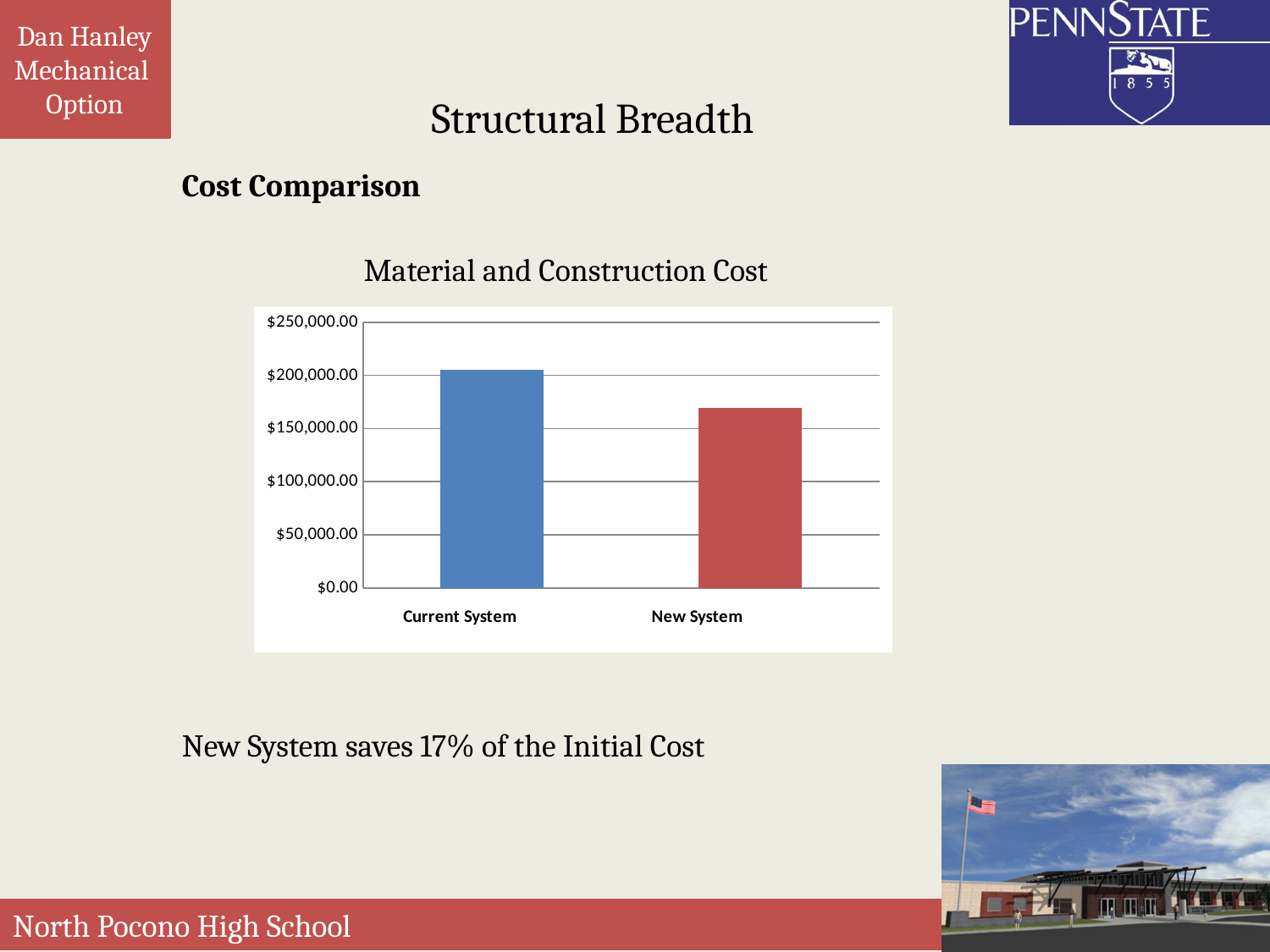
Is the value for New System greater or less than $200,000.00? less Which category has the lowest material and construction cost? New System Which category has the highest material and construction cost? Current System How many categories are shown on the x axis of the chart? 2 What kind of chart is shown on the slide? bar chart Is the value for Current System greater or less than $250,000.00? less Do the values fall or rise from Current System to New System along the x axis? fall Which is larger, the cost for the Current System or the New System? Current System What colour is the bar for the New System? red Is the value for New System greater or less than $150,000.00? greater What is the title of the chart? Material and Construction Cost